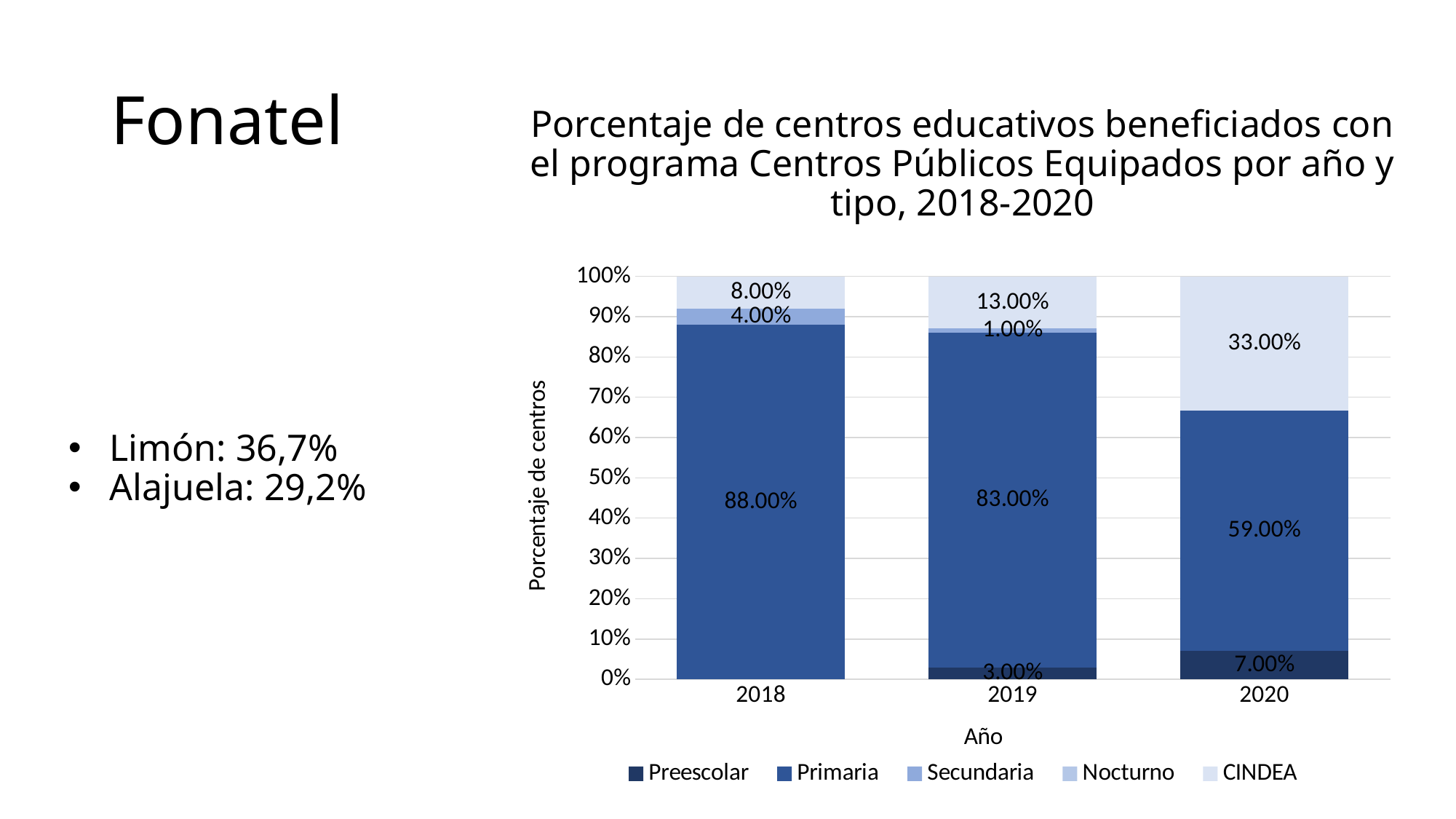
In which year is the Primaria share the highest? 2018 By how many percentage points does the Primaria share in 2018 exceed that in 2020? 29.00% What kind of chart is shown on the slide? stacked bar chart What is the Secundaria value for 2018? 4.00% What is the Preescolar value for 2020? 7.00% Does the Primaria share rise or fall from 2018 to 2020? fall What is the Preescolar value for 2019? 3.00% Which year has the larger Preescolar share, 2019 or 2020? 2020 What is the Primaria value for 2020? 59.00% What percentage does the Primaria segment show for 2018? 88.00% How many series does the legend list? 5 How many years are shown on the x axis? 3